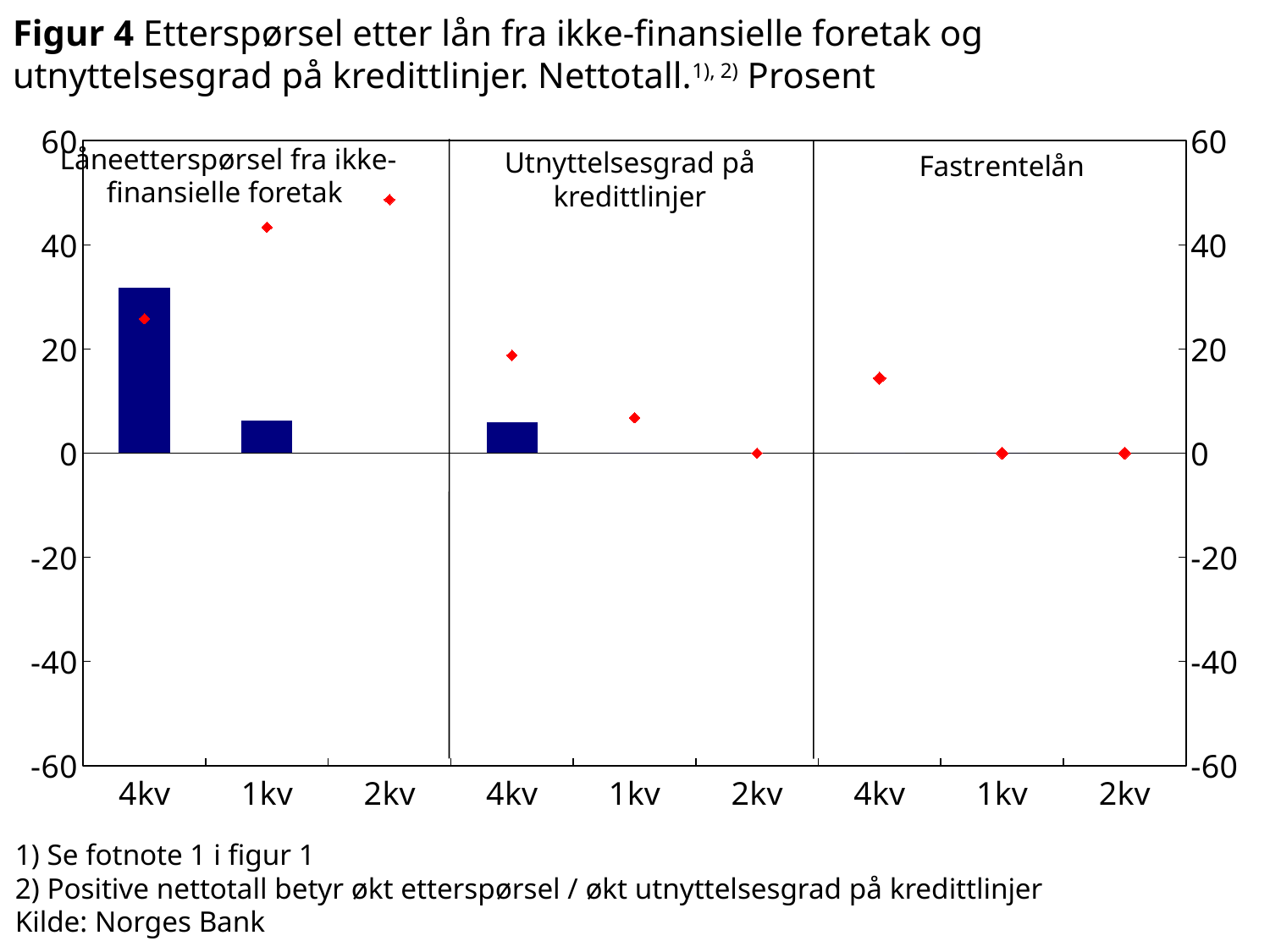
In the panel 'Låneetterspørsel fra ikke-finansielle foretak', is the bar for 4kv greater or less than 20? greater In the panel 'Utnyttelsesgrad på kredittlinjer', do the red diamond markers rise or fall from 4kv to 2kv? fall What kind of chart is shown in Figur 4? combination bar and marker (line) chart In the panel 'Låneetterspørsel fra ikke-finansielle foretak', is the bar for 1kv greater or less than 20? less What is the title of the rightmost panel? Fastrentelån In the panel 'Låneetterspørsel fra ikke-finansielle foretak', which bar is taller, 4kv or 1kv? 4kv How many quarters are shown on the x axis of each panel? 3 In the panel 'Låneetterspørsel fra ikke-finansielle foretak', which quarter has the highest red diamond marker? 2kv In the panel 'Låneetterspørsel fra ikke-finansielle foretak', is the red diamond for 2kv greater or less than 40? greater Which 4kv bar is taller, the one in 'Låneetterspørsel fra ikke-finansielle foretak' or the one in 'Utnyttelsesgrad på kredittlinjer'? Låneetterspørsel fra ikke-finansielle foretak How many panels does the chart have? 3